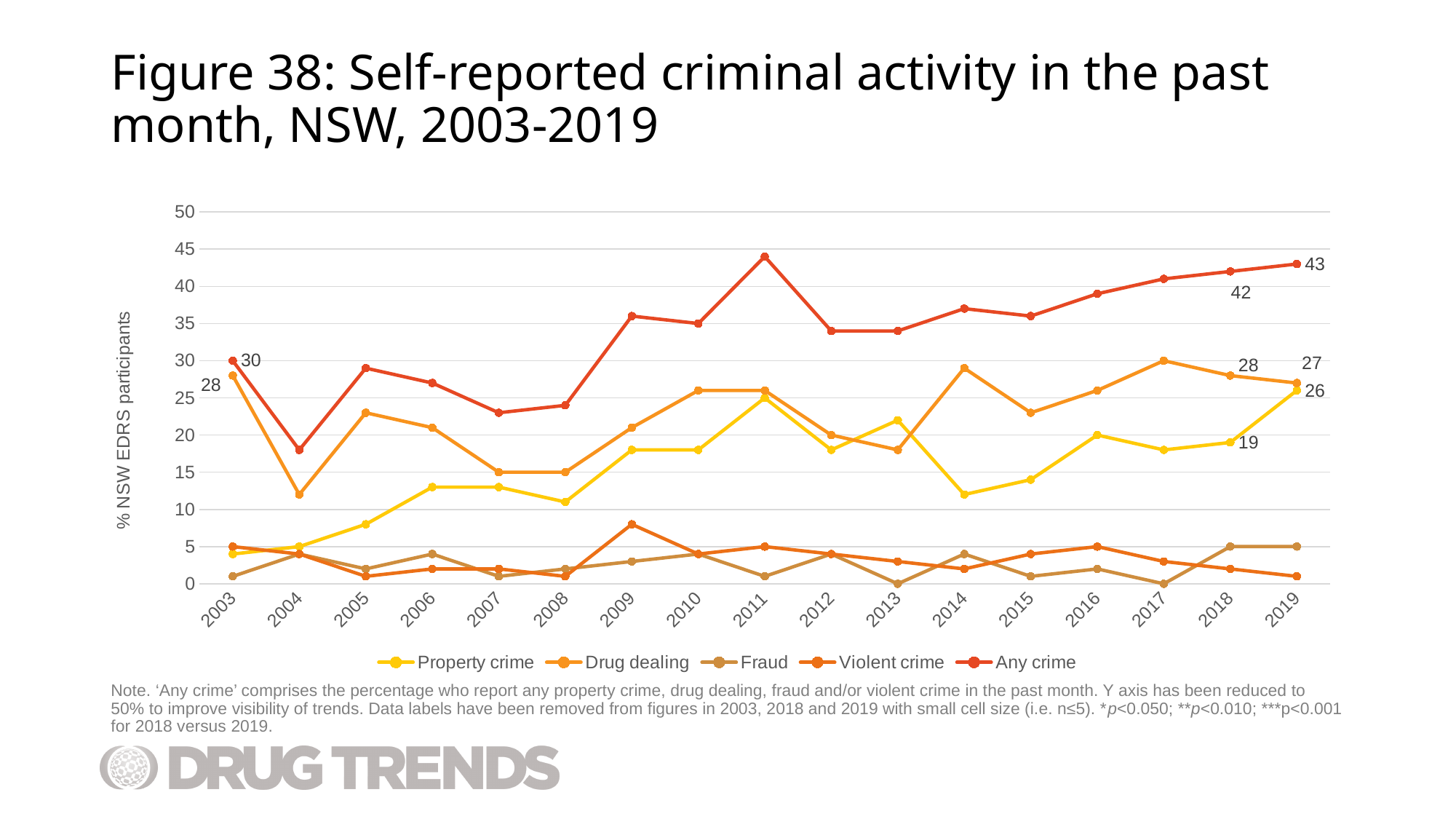
In 2019, which is larger: Drug dealing or Property crime? Drug dealing Is the value for Any crime in 2011 greater or less than 40? greater What is the value for Any crime in 2019? 43 What is the difference between Drug dealing in 2018 and in 2019? 1 By how much did Any crime increase from 2003 to 2019? 13 What is the value for Any crime in 2003? 30 How many years are shown on the x axis? 17 How many series does the legend list? 5 What is the value for Property crime in 2018? 19 What is the value for Drug dealing in 2003? 28 Is the value for Drug dealing in 2004 greater or less than 15? less What kind of chart is shown on the slide? Line chart